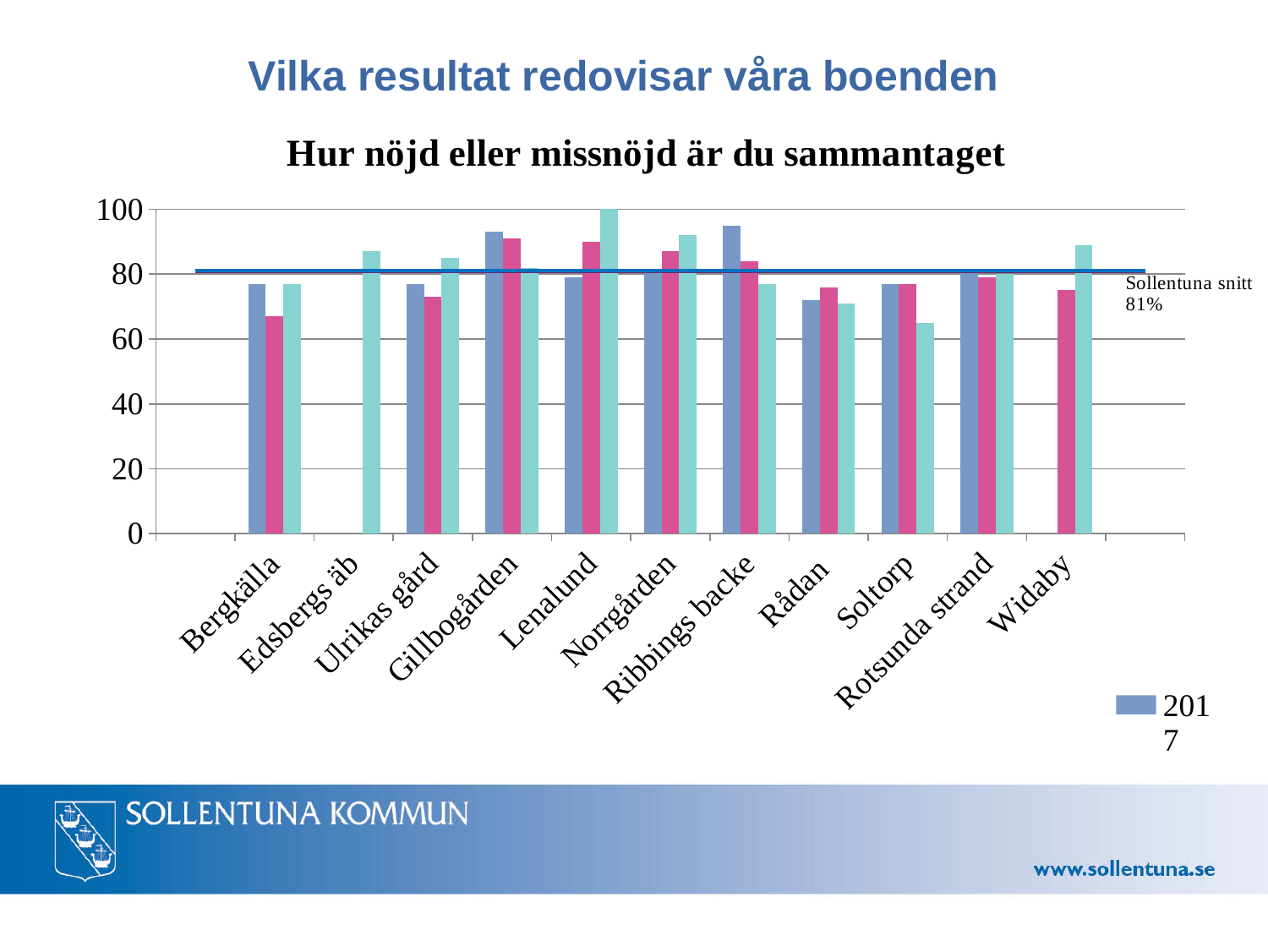
Is the value of the pink bar for Rådan greater or less than 80? less Is the value of the pink bar for Bergkälla greater or less than 80? less How many categories (boenden) are shown on the x axis of the chart? 11 How many series does the chart's legend list? 1 Is the value of the blue bar for Ribbings backe greater or less than 80? greater What value is given for the Sollentuna snitt reference line in the chart? 81% What is the title of the chart? Hur nöjd eller missnöjd är du sammantaget What kind of chart is shown on the slide? bar chart Which category has the tallest bar in the chart? Lenalund